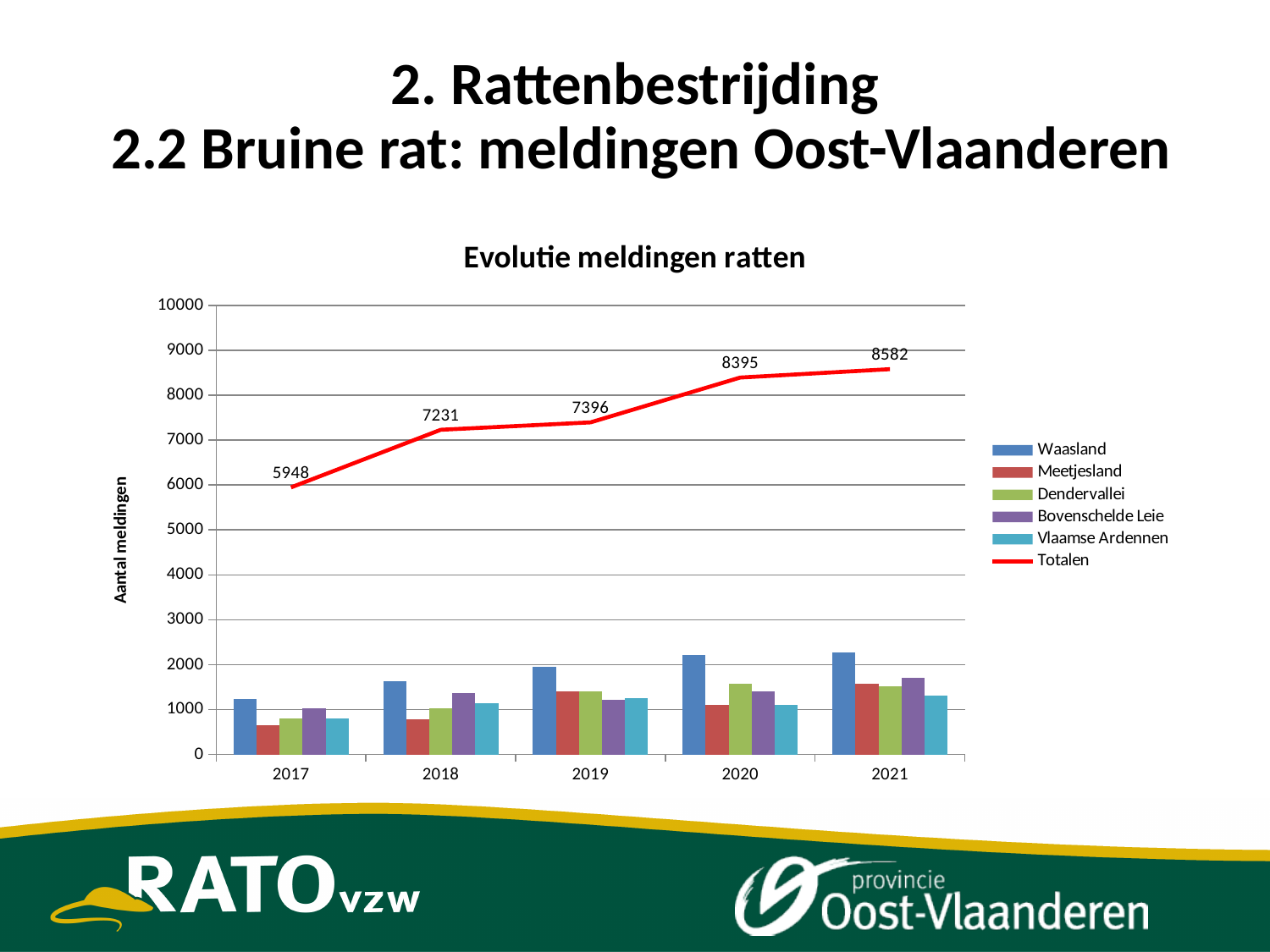
What is the difference between the Totalen values for 2021 and 2017? 2634 What is the value of the Totalen line for 2017? 5948 In which year is the Totalen value highest? 2021 Is the value for Meetjesland in 2017 greater or less than 1000? less What is the value of the Totalen line for 2019? 7396 In which year is the Totalen value lowest? 2017 Does the Totalen line rise or fall from 2017 to 2021? rise Is the value for Waasland in 2021 greater or less than 2000? greater Which year has the larger Totalen value, 2018 or 2019? 2019 How many years are shown on the x axis? 5 How many series does the legend list? 6 What is the value of the Totalen line for 2021? 8582